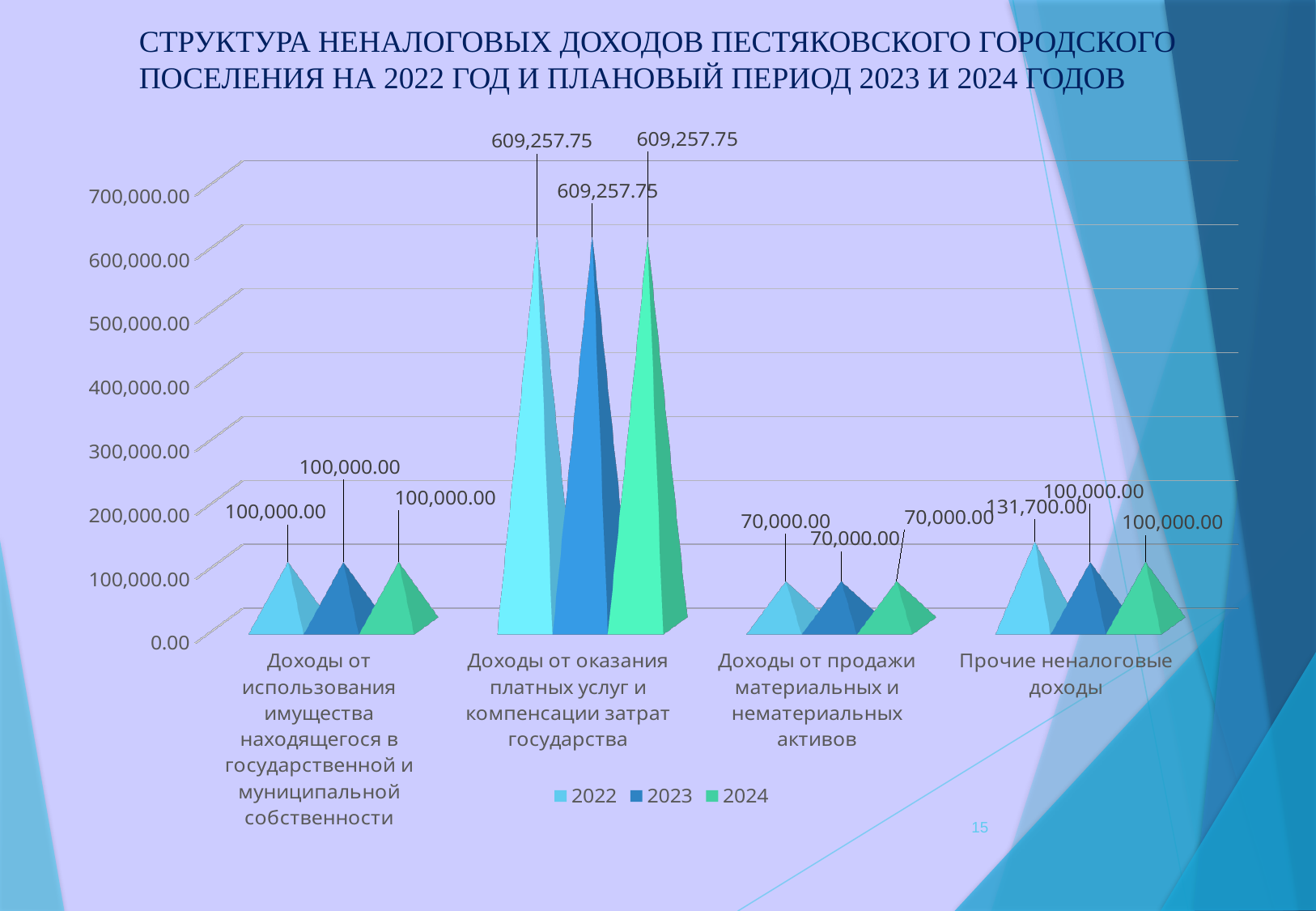
What is the difference between the 2022 value and the 2023 value for "Прочие неналоговые доходы"? 31,700.00 What is the value for 2024 in the category "Доходы от продажи материальных и нематериальных активов"? 70,000.00 Which series are listed in the chart legend? 2022, 2023, 2024 How many categories are shown on the x axis of the chart? 4 What is the value for 2022 in the category "Доходы от оказания платных услуг и компенсации затрат государства"? 609,257.75 How many series does the chart legend list? 3 Which category has the lowest value for 2024? Доходы от продажи материальных и нематериальных активов What is the value for 2022 in the category "Прочие неналоговые доходы"? 131,700.00 What is the difference between the 2022 value for "Доходы от оказания платных услуг и компенсации затрат государства" and the 2022 value for "Доходы от использования имущества находящегося в государственной и муниципальной собственности"? 509,257.75 Which category has the highest value for 2023? Доходы от оказания платных услуг и компенсации затрат государства What is the value for 2023 in the category "Доходы от использования имущества находящегося в государственной и муниципальной собственности"? 100,000.00 Which is larger: the 2022 value for "Прочие неналоговые доходы" or the 2022 value for "Доходы от продажи материальных и нематериальных активов"? Прочие неналоговые доходы